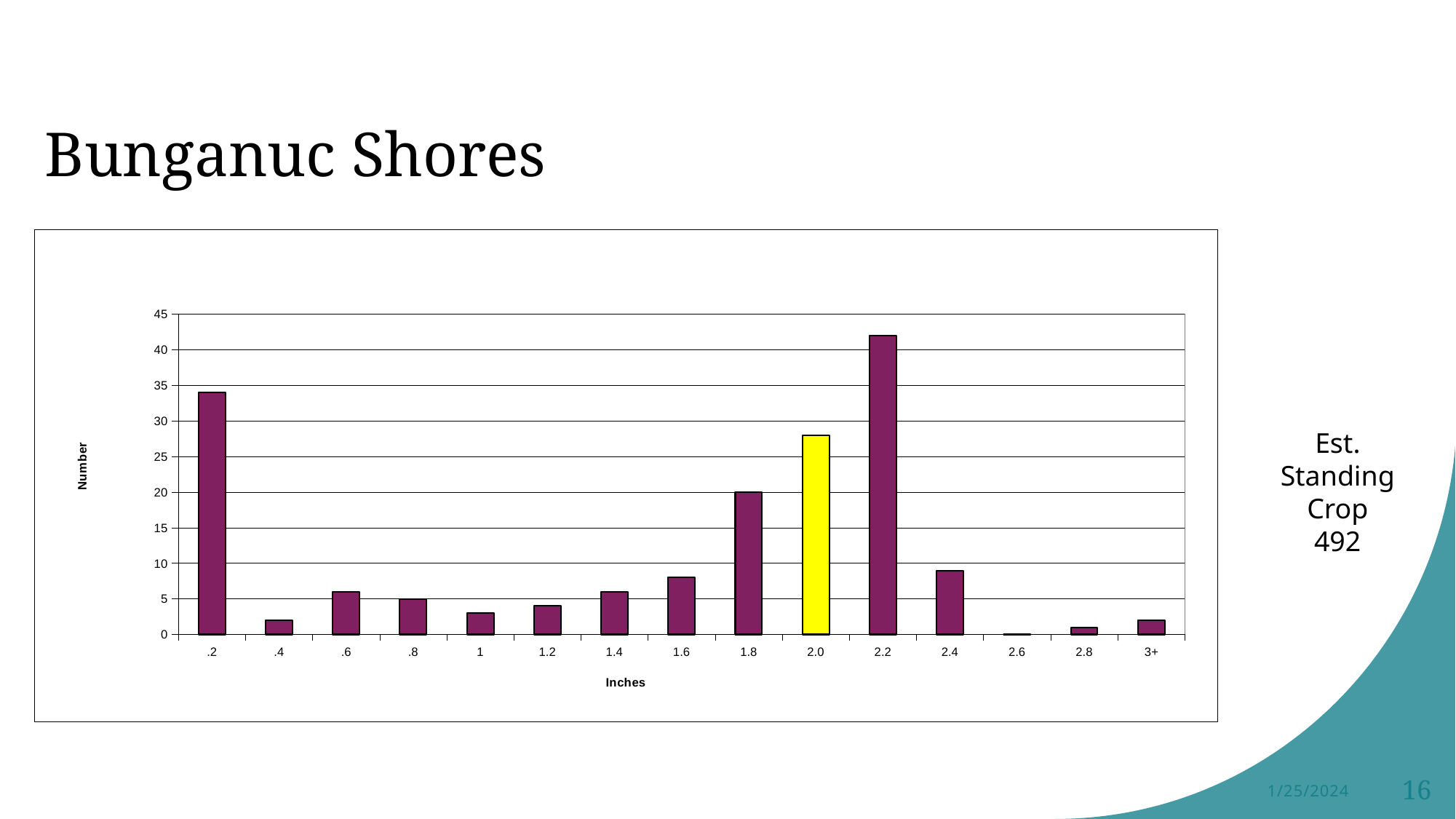
How many inches categories are shown on the x axis? 15 Is the value for .4 greater or less than 5? less What kind of chart is shown on the slide? bar chart What is the label of the x axis? Inches Which inches category has the highest number? 2.2 Is the value for 2.2 greater or less than 40? greater Which inches category has the lowest number? 2.6 Which has a larger value, .2 or 2.0? .2 Is the value for 2.0 greater or less than 25? greater Which inches category is highlighted with a yellow bar? 2.0